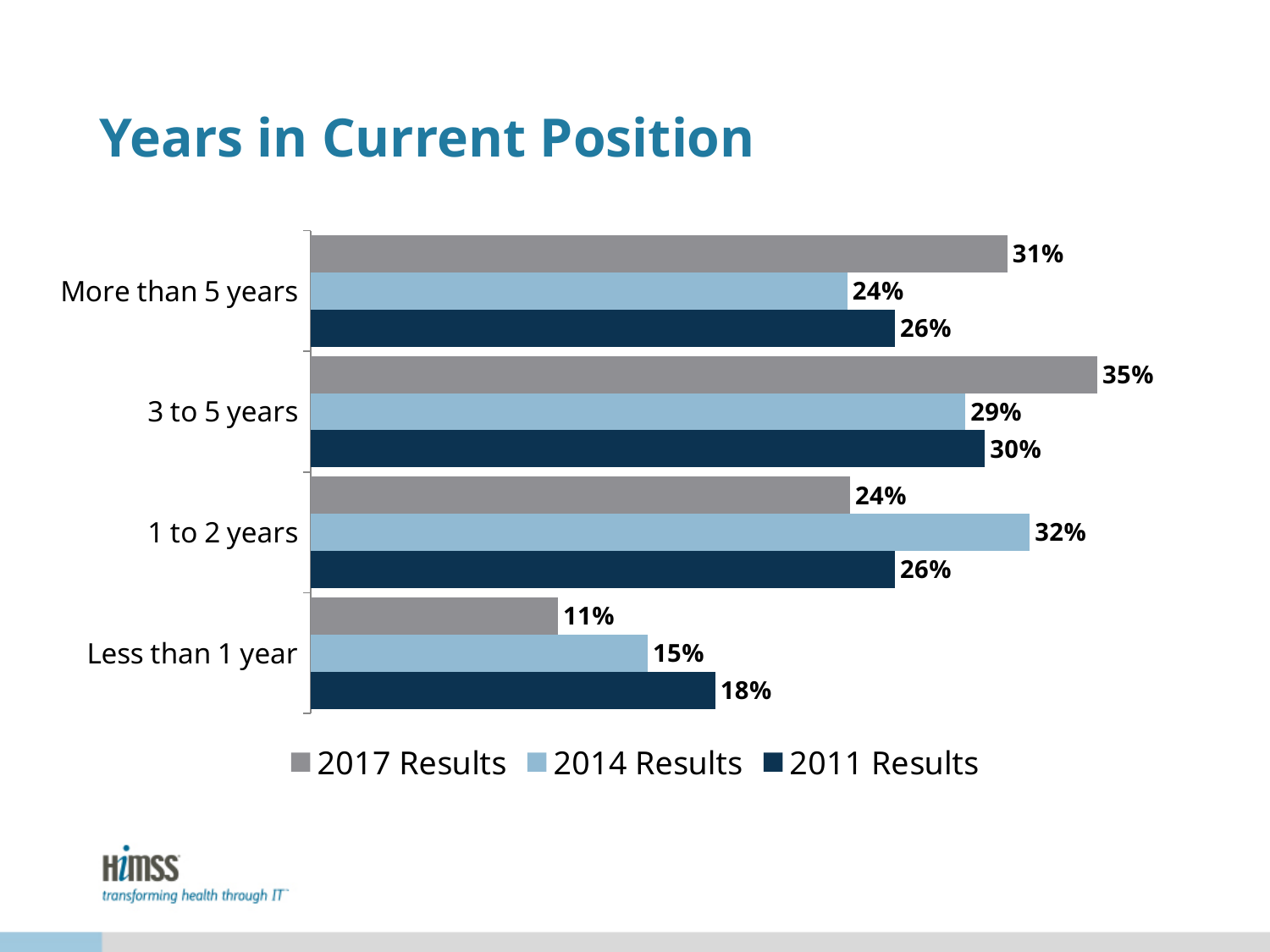
What is the 2011 Results value for 'Less than 1 year'? 18% For '1 to 2 years', which is larger: the 2017 Results value or the 2014 Results value? 2014 Results How many series does the legend list? 3 What kind of chart is shown on the slide? Bar chart Which category has the lowest 2014 Results value? Less than 1 year What is the 2014 Results value for '1 to 2 years'? 32% What is the 2017 Results value for '3 to 5 years'? 35% What is the difference between the 2017 Results and 2014 Results values for 'More than 5 years'? 7% What is the title of the chart? Years in Current Position What is the 2014 Results value for 'More than 5 years'? 24% How many categories are shown on the chart? 4 Which category has the highest 2017 Results value? 3 to 5 years